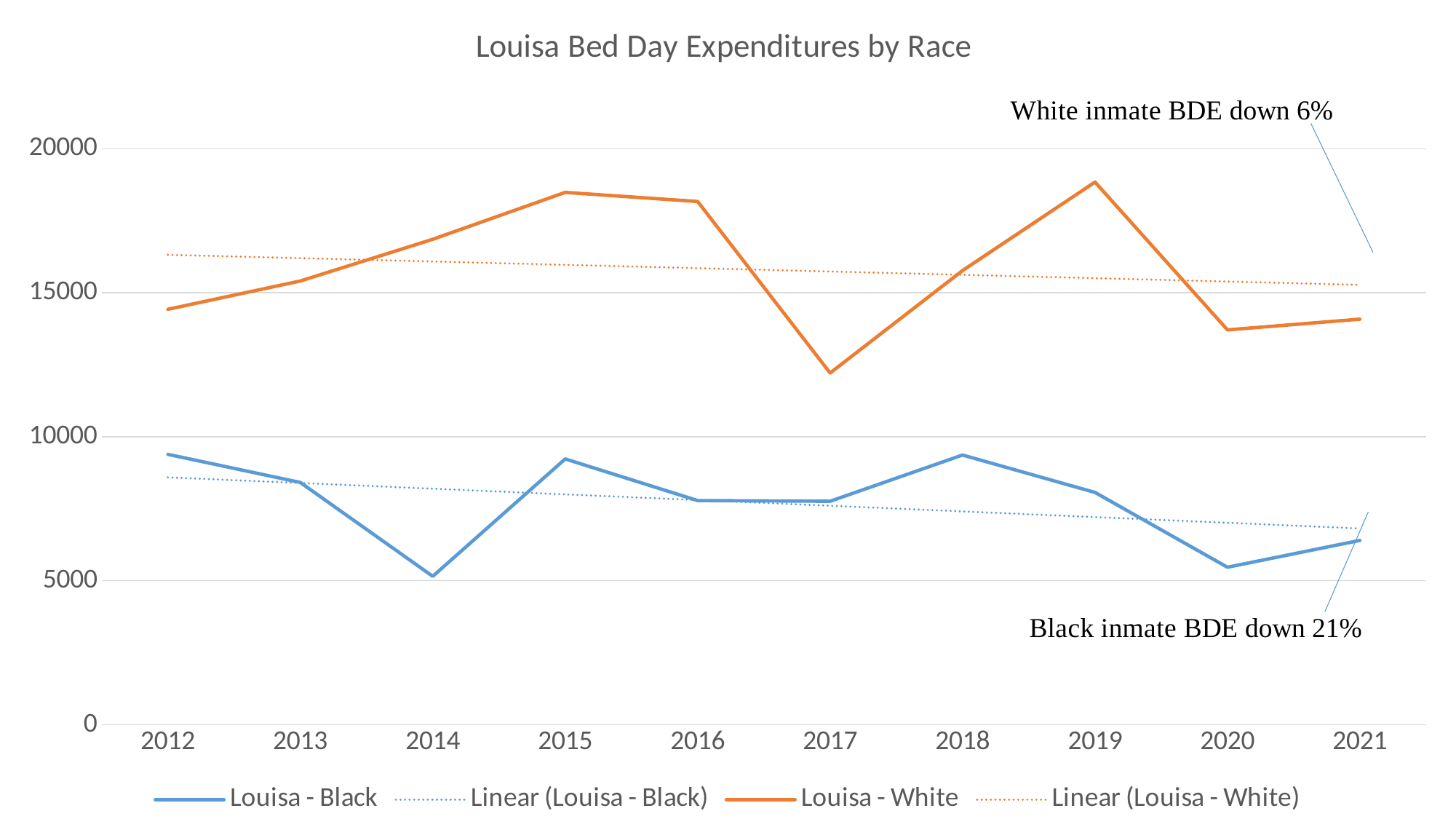
Is the Louisa - White value for 2015 greater or less than 15000? greater According to the annotation on the chart, by what percentage is Black inmate BDE down? 21% Is the Louisa - White value for 2017 greater or less than 15000? less What is the title of the chart? Louisa Bed Day Expenditures by Race In which year is the Louisa - White value lowest? 2017 How many years are shown on the x axis? 10 Does the Linear (Louisa - Black) trend line rise or fall from 2012 to 2021? Fall How many series does the legend list? 4 What kind of chart is shown on the slide? Line chart In which year is the Louisa - Black value lowest? 2014 Which series has the larger value in 2019, Louisa - Black or Louisa - White? Louisa - White